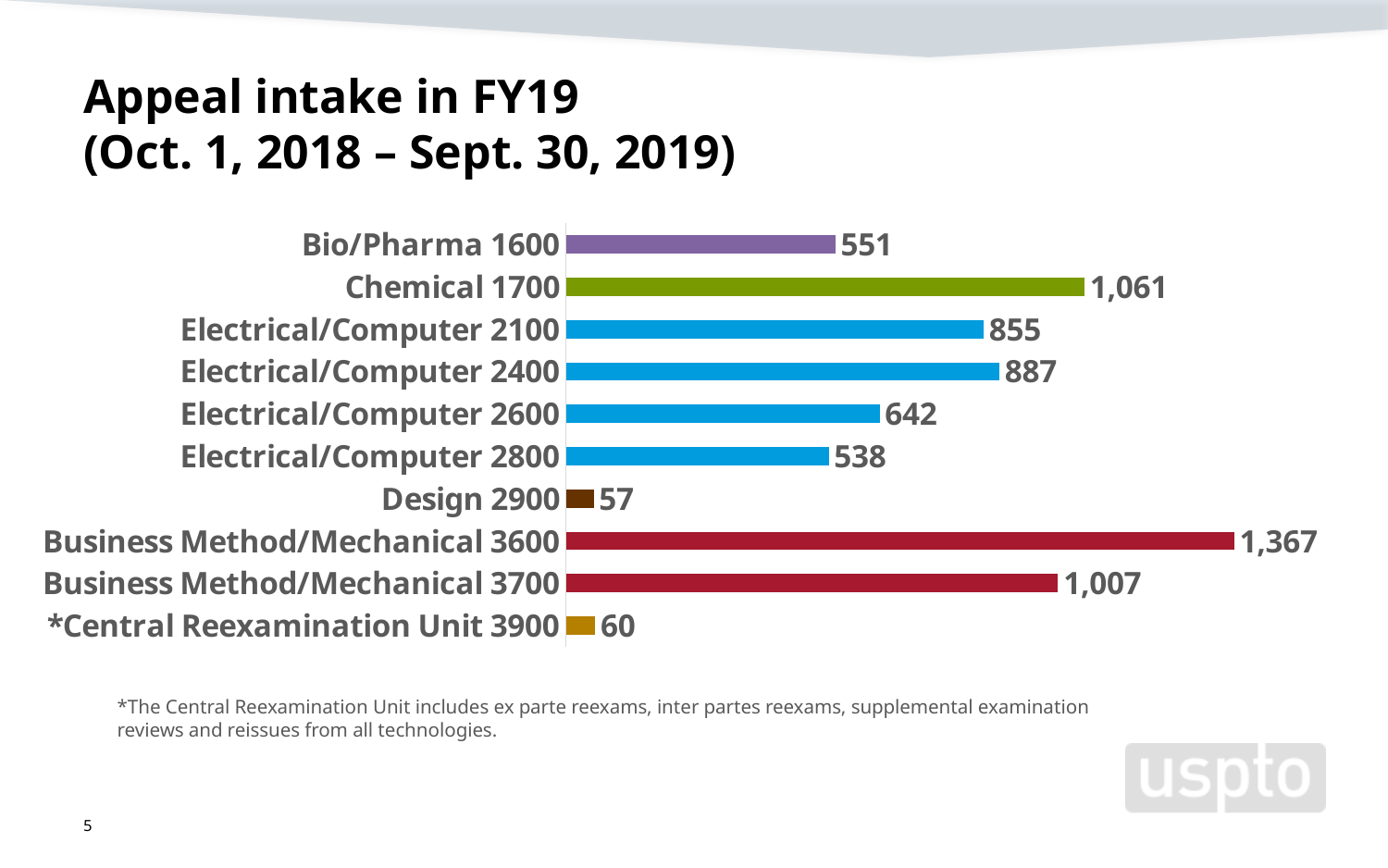
What is the appeal intake value for Design 2900? 57 Which has a larger appeal intake, Chemical 1700 or Electrical/Computer 2400? Chemical 1700 Which category has the lowest appeal intake? Design 2900 What kind of chart is shown on the slide? Bar chart What is the title of the chart on the slide? Appeal intake in FY19 (Oct. 1, 2018 – Sept. 30, 2019) What is the difference between the appeal intake for Electrical/Computer 2400 and Electrical/Computer 2100? 32 Which category has the highest appeal intake? Business Method/Mechanical 3600 What is the appeal intake value for Chemical 1700? 1,061 Which has a larger appeal intake, Bio/Pharma 1600 or Electrical/Computer 2800? Bio/Pharma 1600 How many categories are shown in the chart? 10 What is the appeal intake value for Electrical/Computer 2600? 642 What is the difference between the appeal intake for Business Method/Mechanical 3600 and Business Method/Mechanical 3700? 360